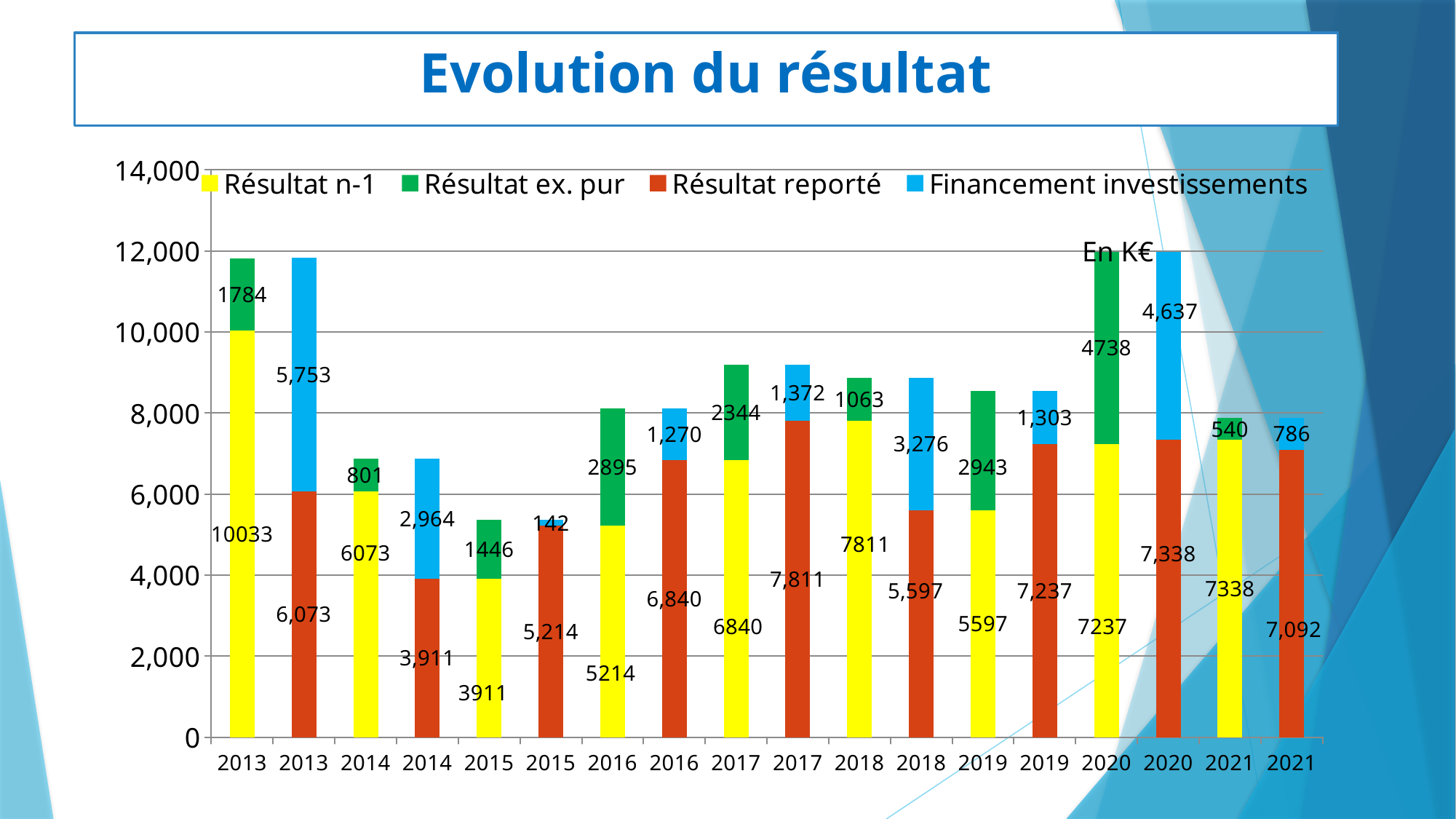
What is the value of Résultat n-1 for 2013? 10033 How many series does the legend list? 4 In which year is Financement investissements the lowest? 2015 What is the value of Financement investissements for 2018? 3,276 What is the difference between Résultat ex. pur in 2020 and in 2021? 4198 In which year is Résultat ex. pur the highest? 2020 What is the title of the chart? Evolution du résultat Which is larger: Résultat reporté in 2017 or Résultat reporté in 2018? 2017 What is the value of Résultat reporté for 2021? 7,092 What kind of chart is shown on the slide? Stacked bar chart How many bars are plotted in the chart? 18 What is the total of the stacked bar made of Résultat n-1 and Résultat ex. pur for 2013? 11817